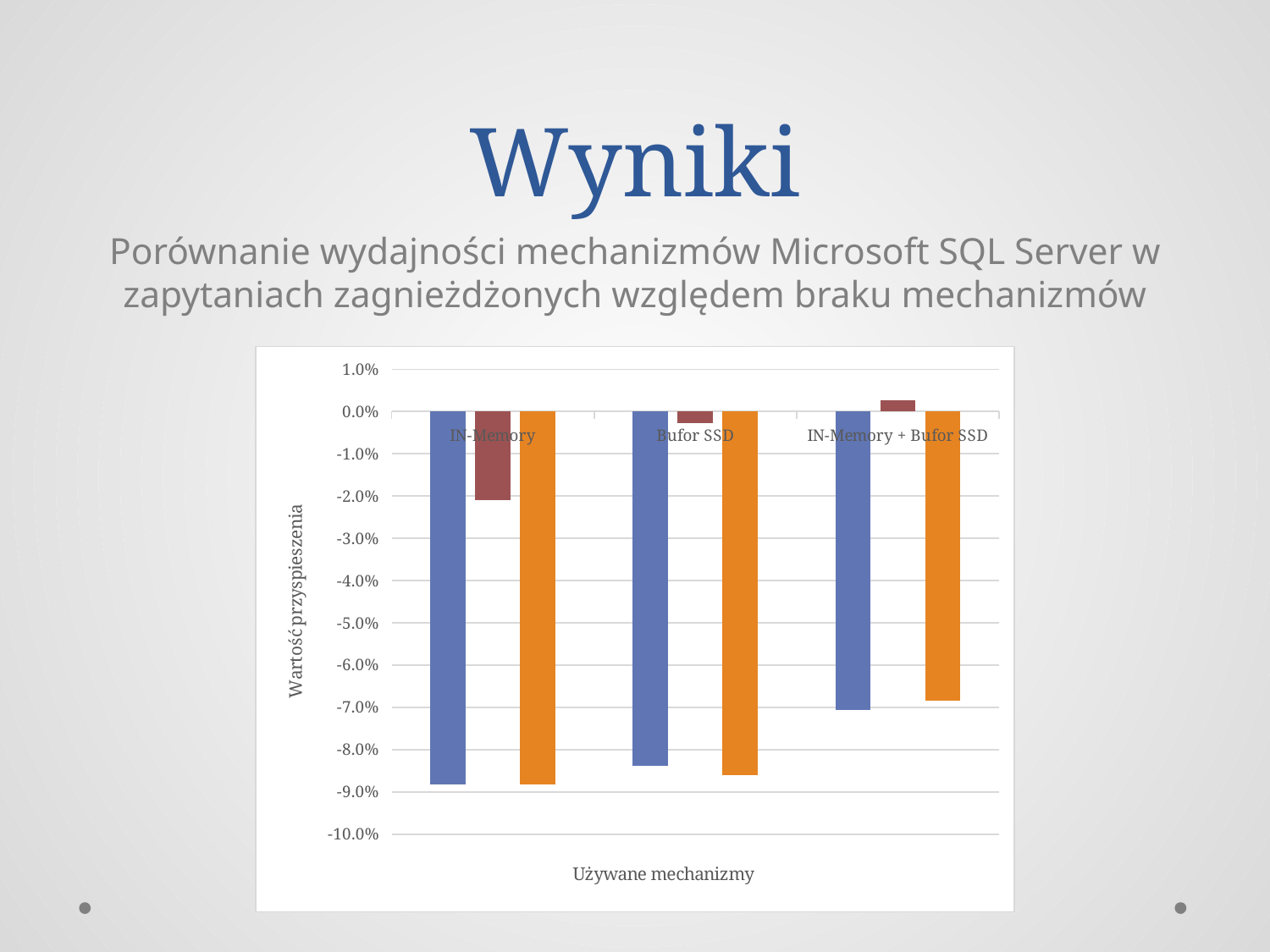
Among the red bars, which category has the lowest value? IN-Memory How many bars are plotted for each category in the chart? 3 Is the value of the red bar for IN-Memory greater or less than -3.0%? greater Is the value of the orange bar for Bufor SSD greater or less than -8.0%? less Is the value of the red bar for IN-Memory + Bufor SSD greater or less than 0.0%? greater What is the title of the vertical axis of the chart? Wartość przyspieszenia Among the red bars, which category has the highest value? IN-Memory + Bufor SSD How many categories are shown on the x axis of the chart? 3 For the IN-Memory category, which is larger: the blue bar or the red bar? the red bar What kind of chart is shown on the slide? bar chart